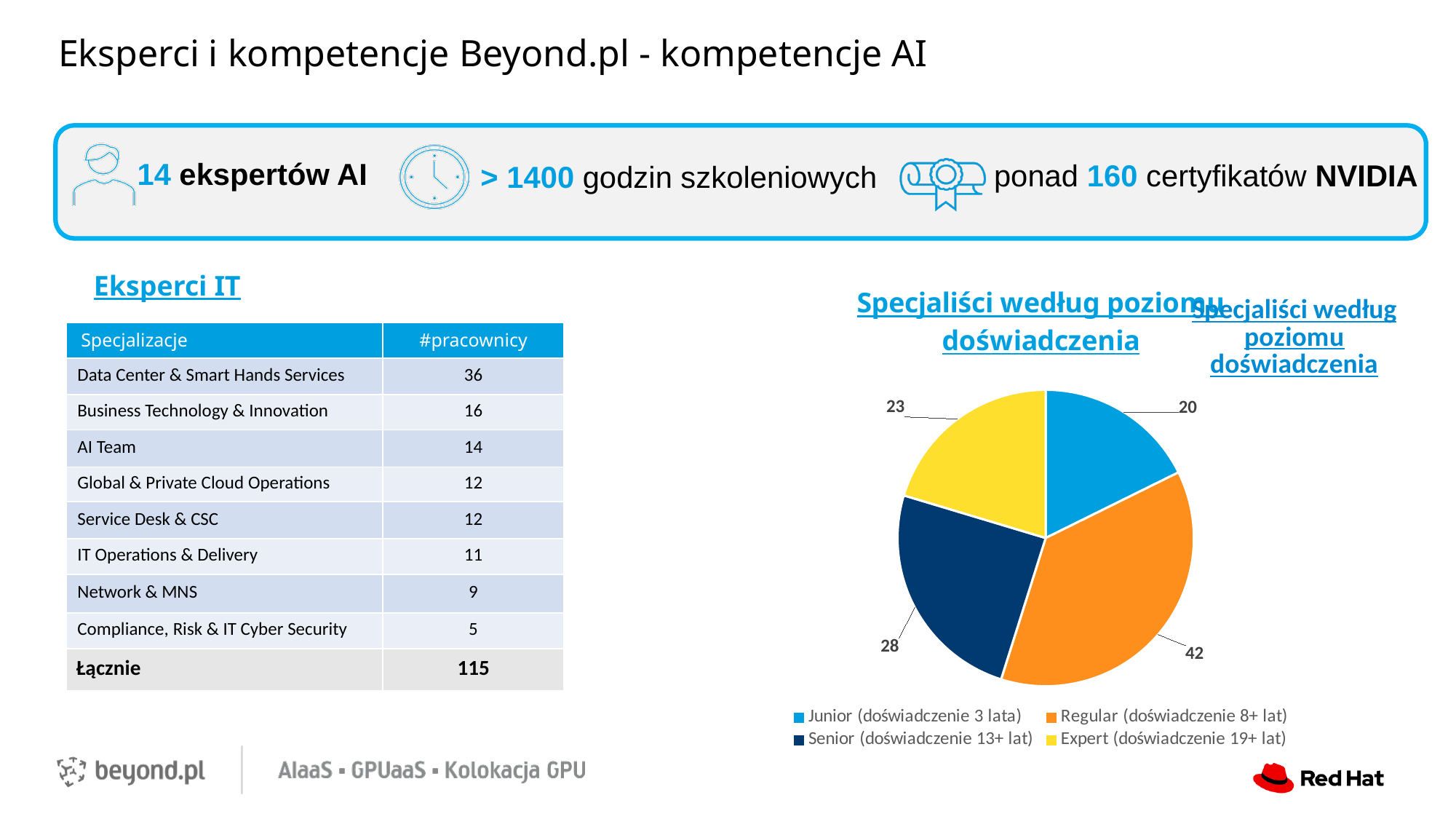
In the pie chart, how many specialists are in the Regular (doświadczenie 8+ lat) category? 42 What kind of chart is shown on the slide? pie chart Which is larger in the pie chart, the Senior value or the Expert value? Senior What colour is the Expert (doświadczenie 19+ lat) slice in the pie chart? yellow Which experience level has the largest slice in the pie chart? Regular (doświadczenie 8+ lat) In the pie chart, how many specialists are in the Senior (doświadczenie 13+ lat) category? 28 What is the difference between the Regular and Junior values in the pie chart? 22 In the pie chart, how many specialists are in the Expert (doświadczenie 19+ lat) category? 23 Which experience level has the smallest slice in the pie chart? Junior (doświadczenie 3 lata) What is the total of all values shown in the pie chart? 113 In the pie chart, how many specialists are in the Junior (doświadczenie 3 lata) category? 20 How many slices does the pie chart have? 4